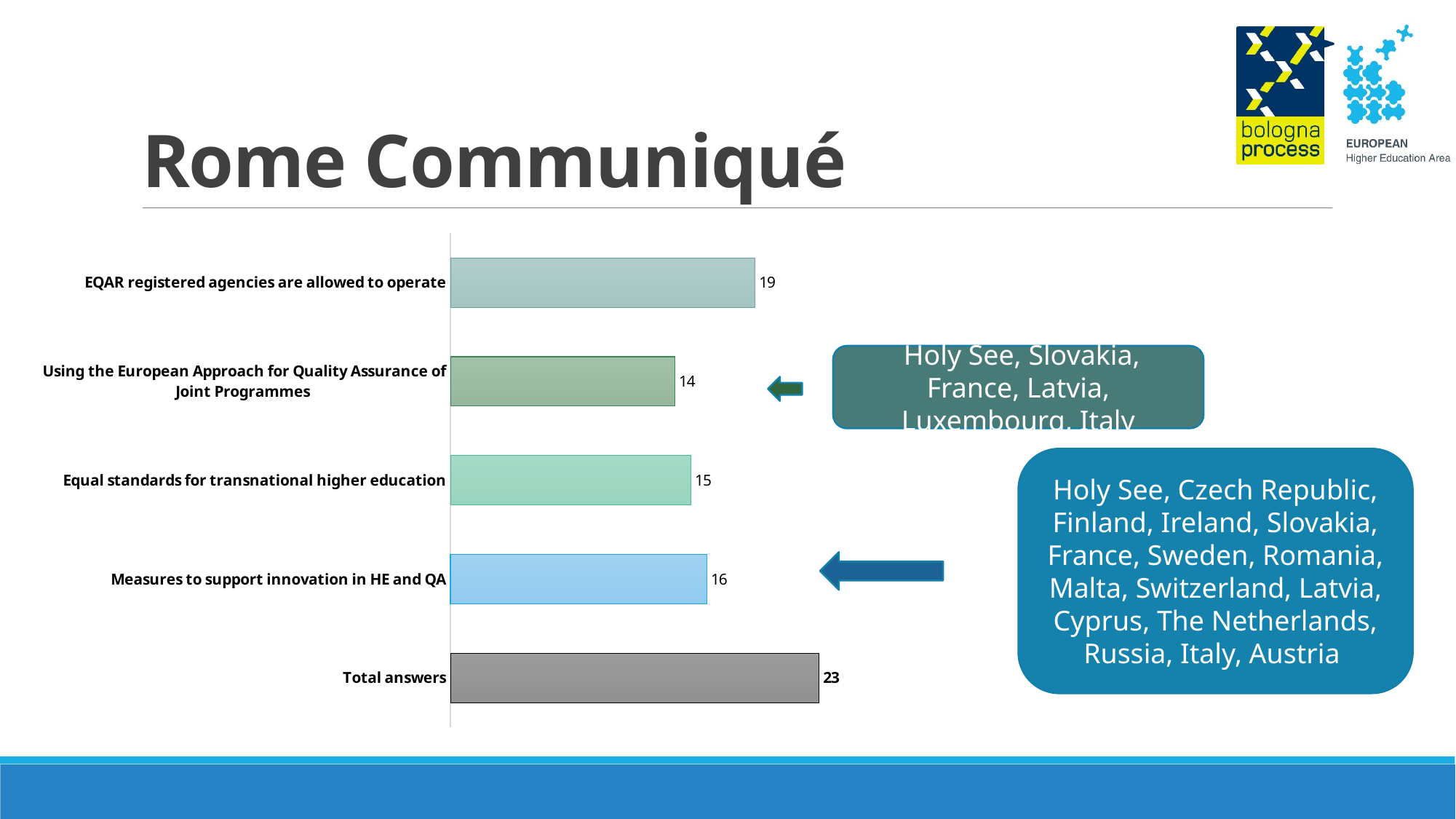
How many categories are shown in the chart? 5 Which category has the lowest value? Using the European Approach for Quality Assurance of Joint Programmes What is the value for 'EQAR registered agencies are allowed to operate'? 19 What is the value for 'Measures to support innovation in HE and QA'? 16 What is the value for 'Total answers'? 23 What is the difference between 'Total answers' and 'EQAR registered agencies are allowed to operate'? 4 What colour is the bar for 'Total answers'? Grey Which is larger: 'Equal standards for transnational higher education' or 'Measures to support innovation in HE and QA'? Measures to support innovation in HE and QA Which category has the highest value? Total answers What is the value for 'Using the European Approach for Quality Assurance of Joint Programmes'? 14 What is the value for 'Equal standards for transnational higher education'? 15 What kind of chart is shown on the slide? Bar chart